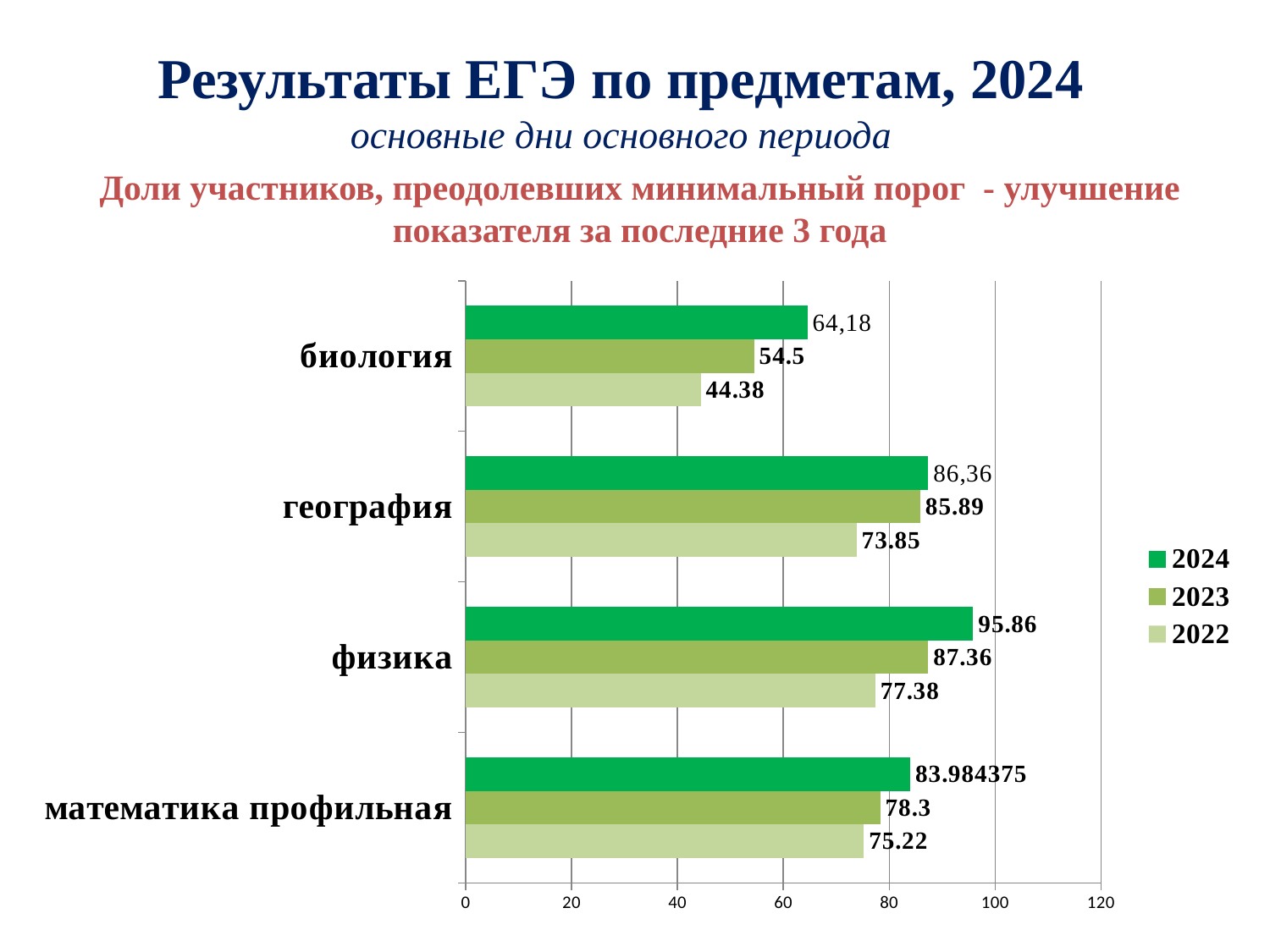
What is the value for физика in 2024? 95.86 What kind of chart is shown on the slide? bar chart Which is larger: the 2023 value for математика профильная or the 2023 value for география? география What is the value for география in 2023? 85.89 What is the value for биология in 2022? 44.38 What is the difference between the 2023 and 2022 values for физика? 9.98 How many series does the legend list? 3 What is the value for математика профильная in 2024? 83.984375 Which subject has the lowest value in 2022? биология Which subject has the highest value in 2024? физика Is the value for биология in 2024 greater or less than 60? greater How many subjects are shown on the chart? 4